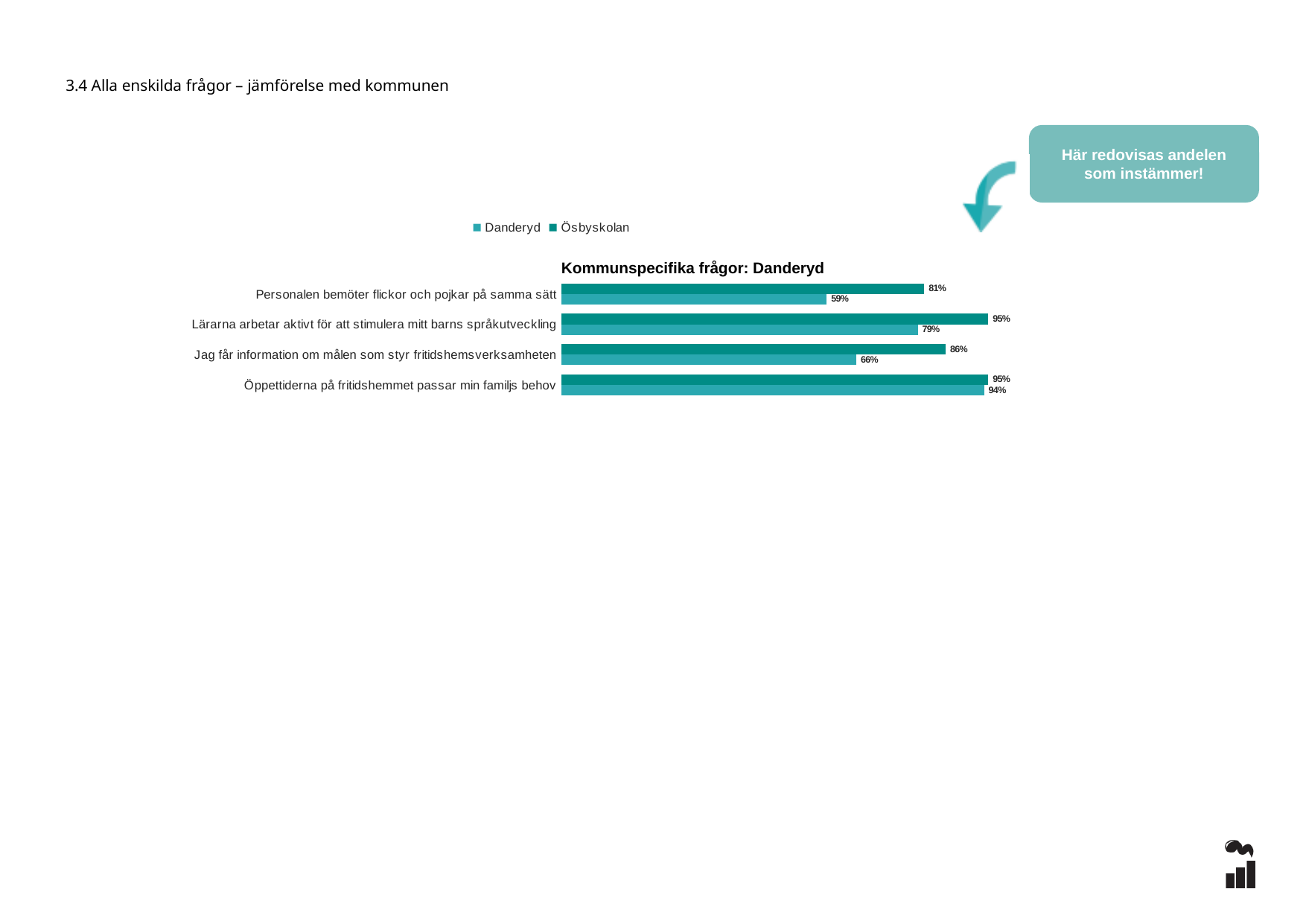
For 'Jag får information om målen som styr fritidshemsverksamheten', which is larger: the Ösbyskolan value or the Danderyd value? Ösbyskolan Which category has the lowest Danderyd value? Personalen bemöter flickor och pojkar på samma sätt What is the Ösbyskolan value for 'Jag får information om målen som styr fritidshemsverksamheten'? 86% What is the Danderyd value for 'Öppettiderna på fritidshemmet passar min familjs behov'? 94% What is the title of the chart? Kommunspecifika frågor: Danderyd What is the Danderyd value for 'Personalen bemöter flickor och pojkar på samma sätt'? 59% How many categories (questions) are shown in the chart? 4 How many series does the legend list? 2 What is the difference between the Ösbyskolan and Danderyd values for 'Personalen bemöter flickor och pojkar på samma sätt'? 22% What is the Ösbyskolan value for 'Personalen bemöter flickor och pojkar på samma sätt'? 81% What is the Danderyd value for 'Lärarna arbetar aktivt för att stimulera mitt barns språkutveckling'? 79% What type of chart is shown on the slide? bar chart